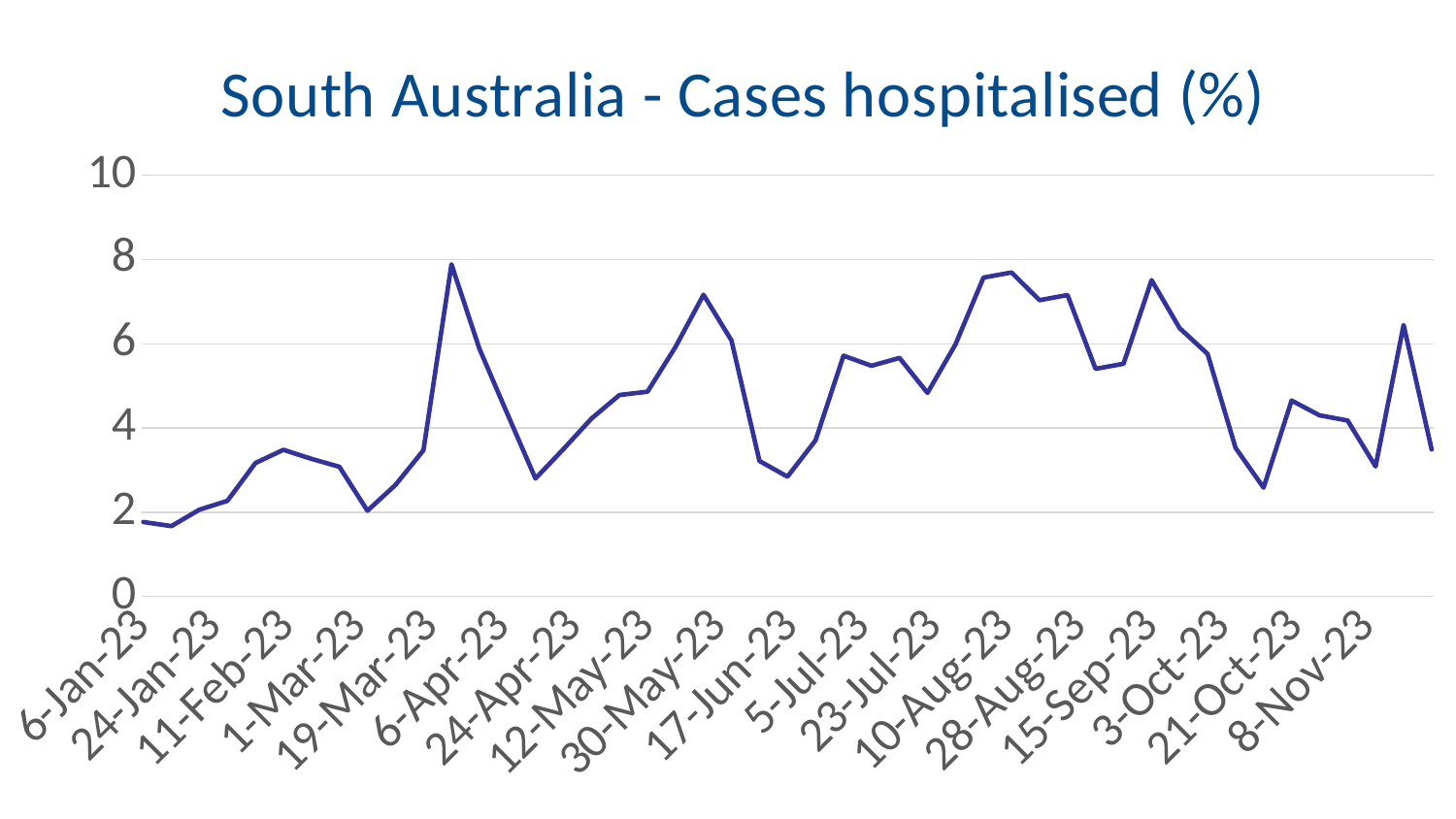
Does the line generally rise or fall between 6-Jan-23 and 6-Apr-23? rise Is the value for 30-May-23 greater or less than 6? greater Is the value for 21-Oct-23 greater or less than 4? greater Is the value for 6-Apr-23 greater or less than 6? less What is the highest value shown on the y axis? 10 How many date labels are shown along the x axis? 18 What is the title of the chart? South Australia - Cases hospitalised (%) What kind of chart is shown on the slide? line chart Which has the larger value, 6-Apr-23 or 24-Apr-23? 6-Apr-23